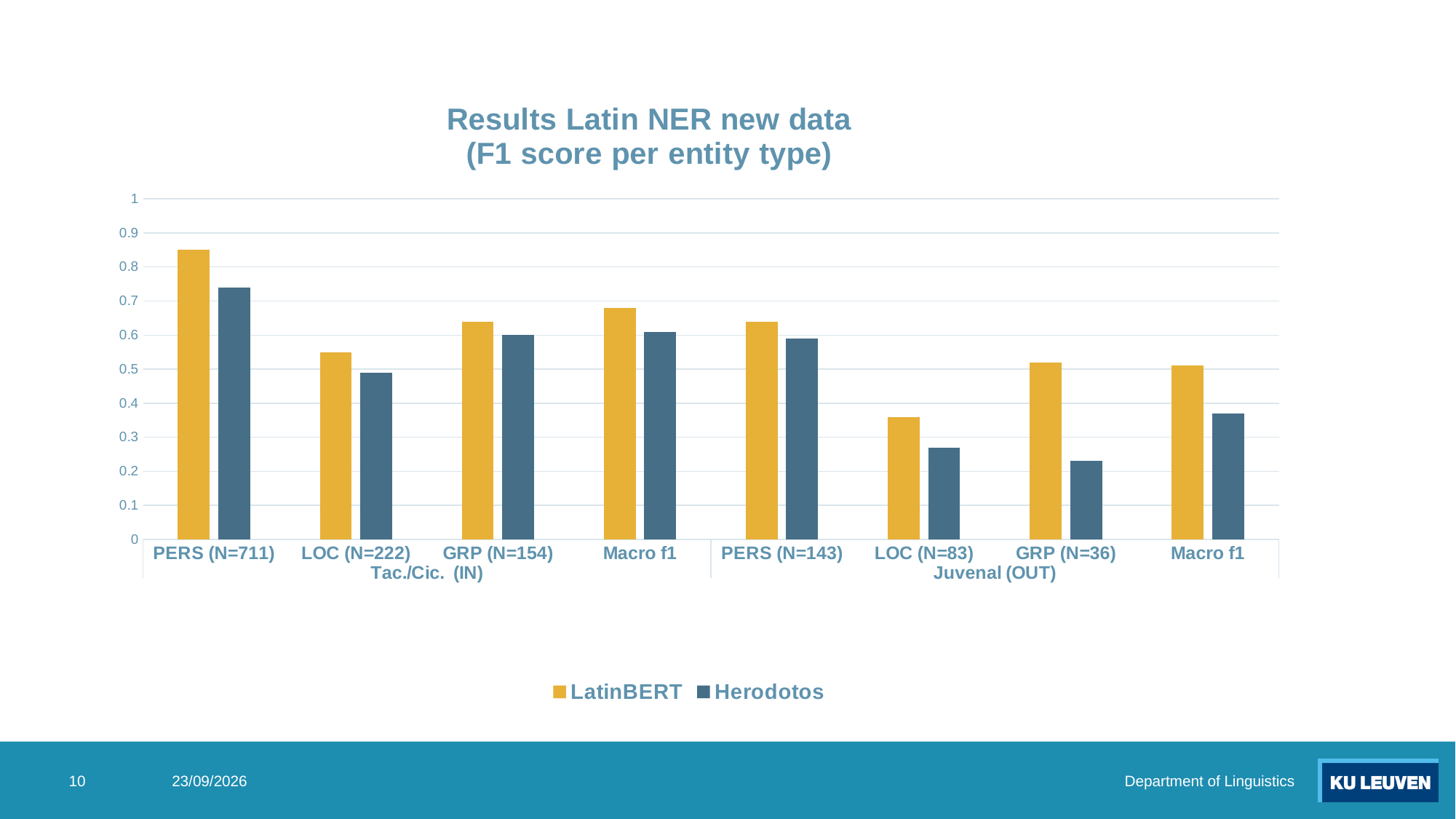
Is the Herodotos value for GRP (N=36) greater or less than 0.3? less Which category has the lowest Herodotos bar? GRP (N=36) How many categories are shown along the x axis? 8 Is the LatinBERT value for PERS (N=711) greater or less than 0.8? greater What kind of chart is shown on the slide? bar chart Is the Herodotos value for PERS (N=711) greater or less than 0.7? greater Which series is shown in yellow in the legend? LatinBERT Which category has the highest LatinBERT bar? PERS (N=711) For GRP (N=36), which series has the larger value, LatinBERT or Herodotos? LatinBERT How many series does the legend list? 2 What is the title of the chart? Results Latin NER new data (F1 score per entity type)